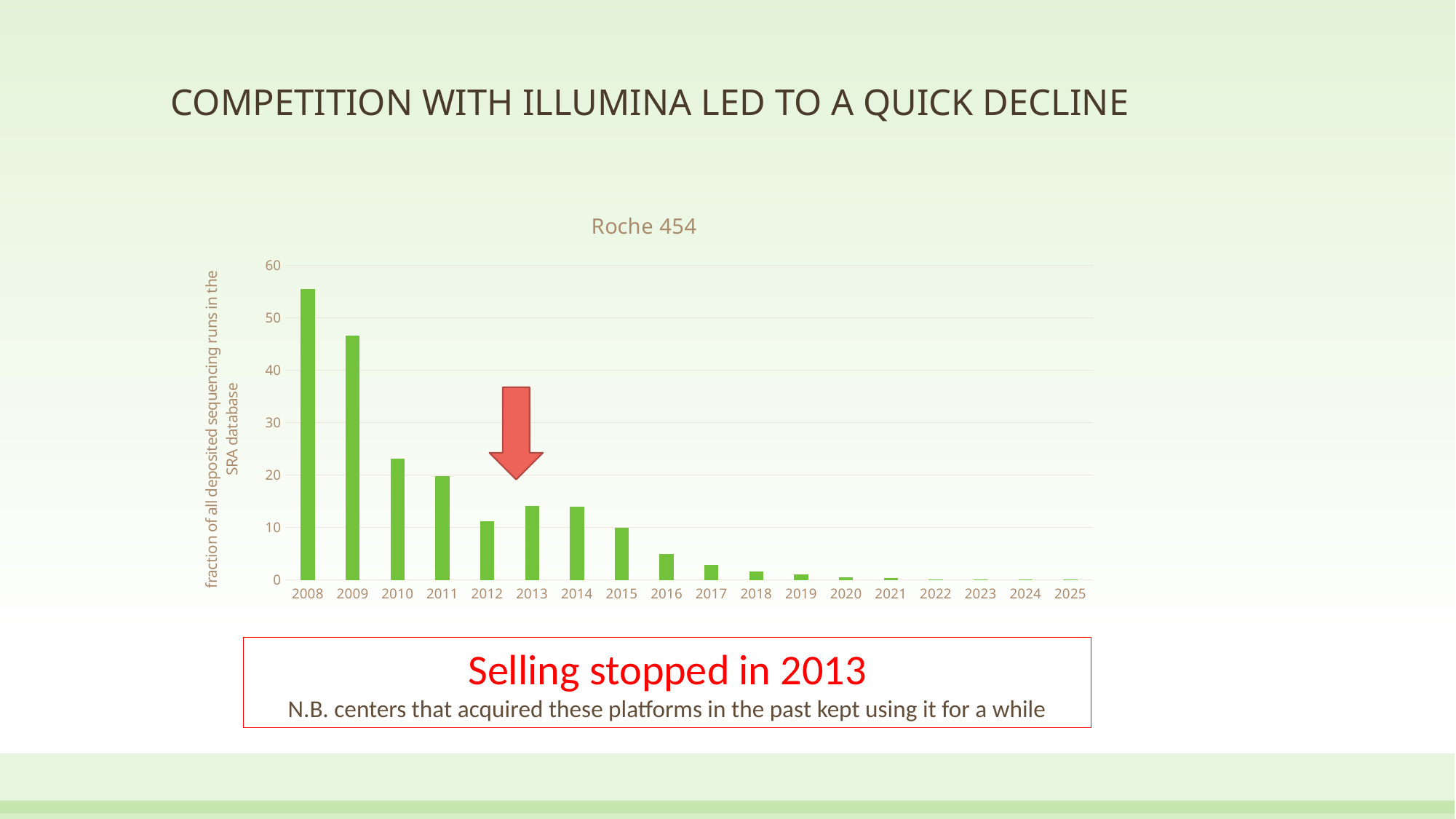
What is the label on the y axis of the chart? fraction of all deposited sequencing runs in the SRA database What kind of chart is shown on the slide? Bar chart Do the values generally rise or fall from 2008 to 2025? Fall Which year has the highest value in the chart? 2008 Which year has the larger value, 2008 or 2009? 2008 Is the value for 2010 greater or less than 20? greater Is the value for 2009 greater or less than 50? less Is the value for 2008 greater or less than 50? greater What is the title of the chart? Roche 454 Which year has the larger value, 2012 or 2013? 2013 How many years are shown on the x axis of the chart? 18